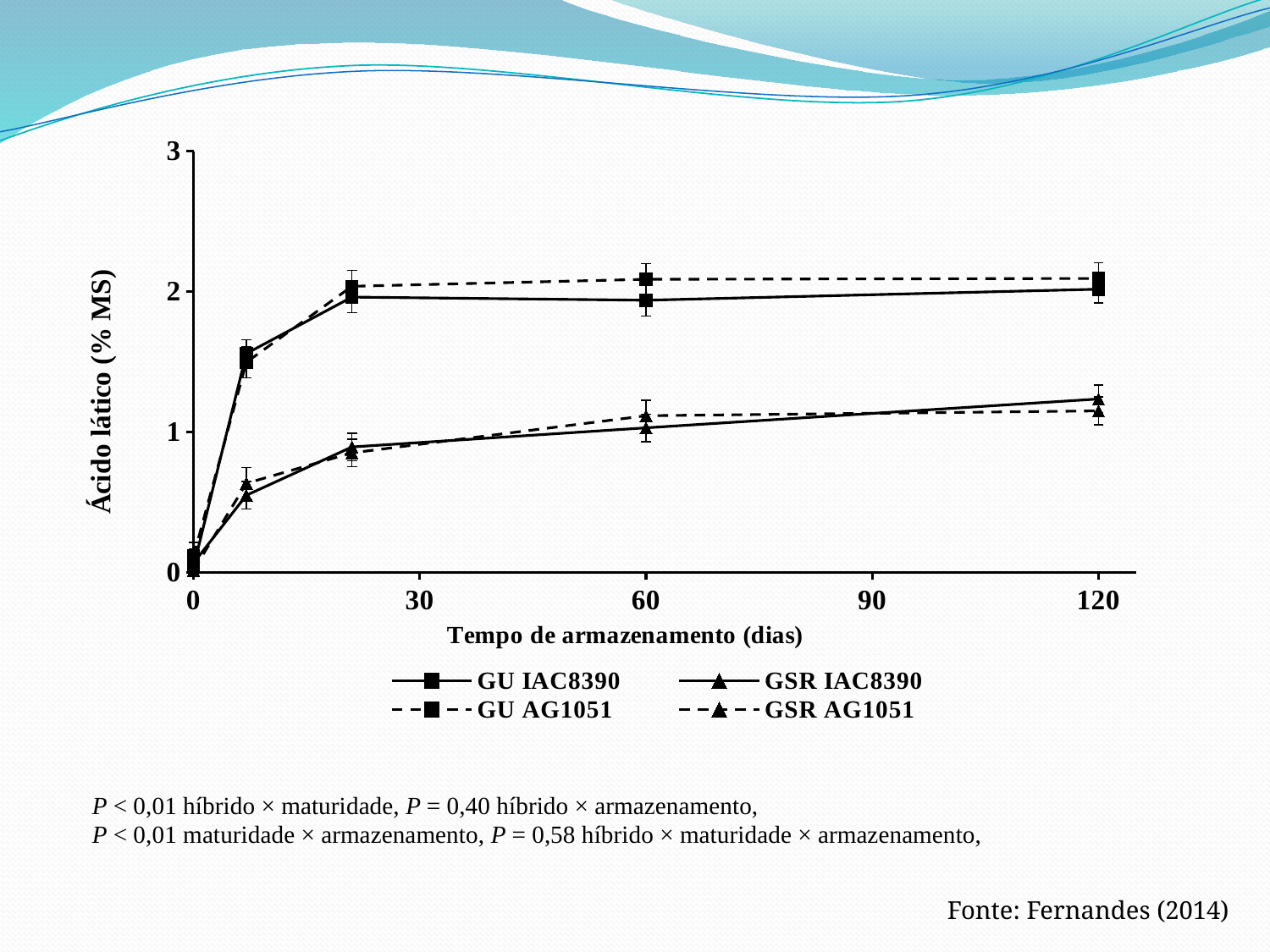
What kind of chart is shown on the slide? line chart What is the title of the y axis? Ácido lático (% MS) Is the value for GU IAC8390 at 120 days greater or less than 1? greater Is the value for GSR AG1051 at 120 days greater or less than 1? greater How many series does the legend list? 4 What is the title of the x axis? Tempo de armazenamento (dias) How many tick labels are shown on the x axis? 5 Is the value for GU AG1051 at 0 days greater or less than 1? less Do the values for GSR IAC8390 rise or fall as storage time increases from 0 to 120 days? rise At 60 days, which is larger: GU IAC8390 or GSR IAC8390? GU IAC8390 At 120 days, which is larger: GU AG1051 or GSR AG1051? GU AG1051